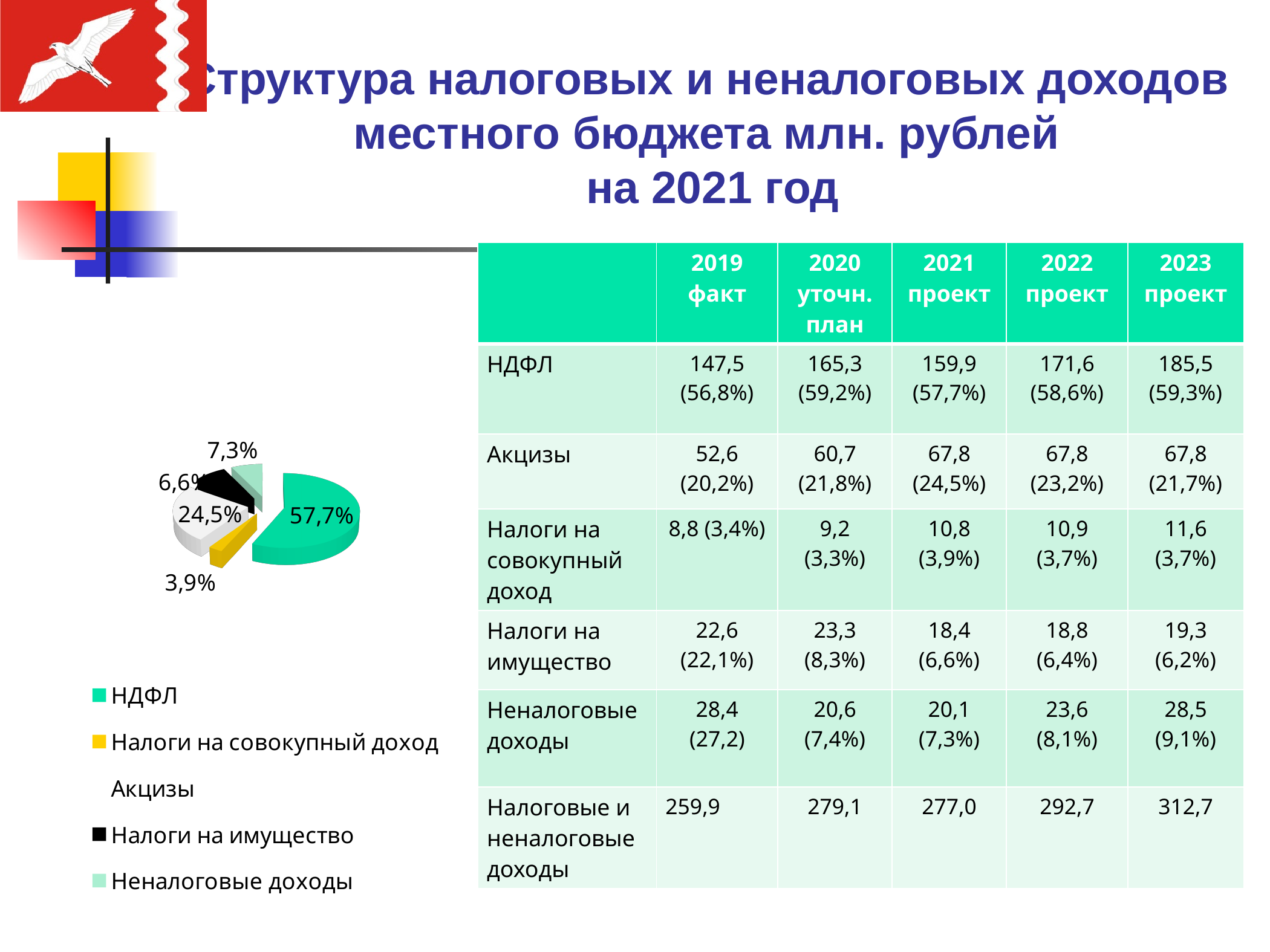
Which category has the smallest slice in the pie chart? Налоги на совокупный доход In the pie chart, which is larger: Неналоговые доходы or Налоги на имущество? Неналоговые доходы Which category has the largest slice in the pie chart? НДФЛ How many slices does the pie chart have? 5 What colour is the НДФЛ slice in the pie chart? green What share of the pie chart does Налоги на имущество have? 6,6% What share of the pie chart does Неналоговые доходы have? 7,3% What kind of chart is shown on the left of the slide? pie chart In the pie chart, what is the difference in percentage points between НДФЛ and Акцизы? 33,2 What share of the pie chart does Акцизы have? 24,5% What share of the pie chart does Налоги на совокупный доход have? 3,9% What share of the pie chart does НДФЛ have? 57,7%